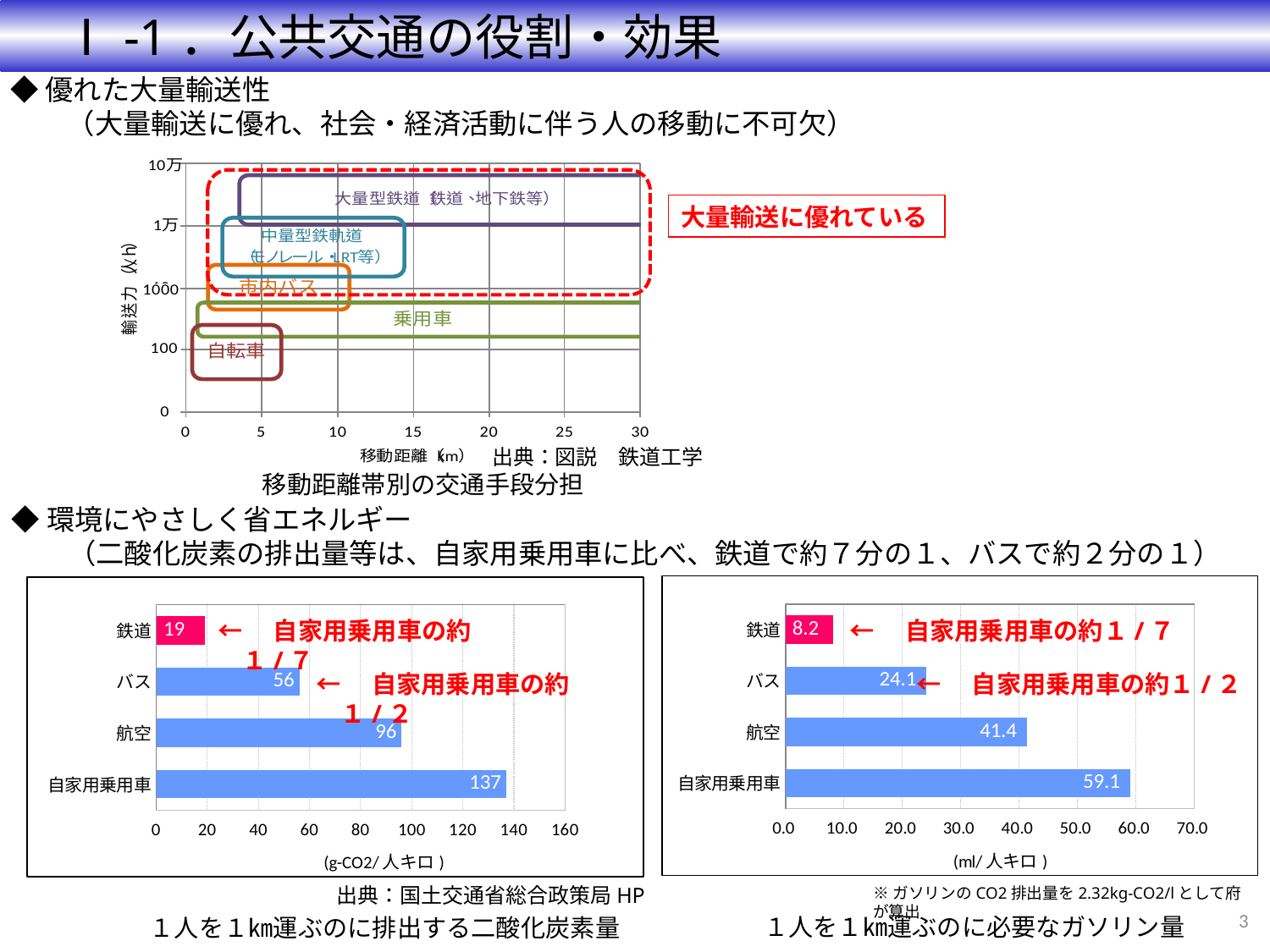
What kind of chart is the bottom-left chart (1人を1km運ぶのに排出する二酸化炭素量)? bar chart In the bottom-right chart (1人を1km運ぶのに必要なガソリン量), what is the difference between 自家用乗用車 and バス? 35.0 In the bottom-left chart (1人を1km運ぶのに排出する二酸化炭素量), how many categories are shown? 4 In the bottom-right chart (1人を1km運ぶのに必要なガソリン量), which category has the highest value? 自家用乗用車 In the bottom-right chart (1人を1km運ぶのに必要なガソリン量), what is the value for 航空? 41.4 In the bottom-left chart (1人を1km運ぶのに排出する二酸化炭素量), which category has the lowest value? 鉄道 In the bottom-left chart (1人を1km運ぶのに排出する二酸化炭素量), what is the value for バス? 56 In the bottom-right chart (1人を1km運ぶのに必要なガソリン量), what is the value for 鉄道? 8.2 In the bottom-right chart (1人を1km運ぶのに必要なガソリン量), which is larger, バス or 航空? 航空 In the bottom-left chart (1人を1km運ぶのに排出する二酸化炭素量), what is the value for 自家用乗用車? 137 In the bottom-left chart (1人を1km運ぶのに排出する二酸化炭素量), what is the difference between 自家用乗用車 and 航空? 41 What unit is shown on the x axis of the bottom-right chart (1人を1km運ぶのに必要なガソリン量)? ml/人キロ